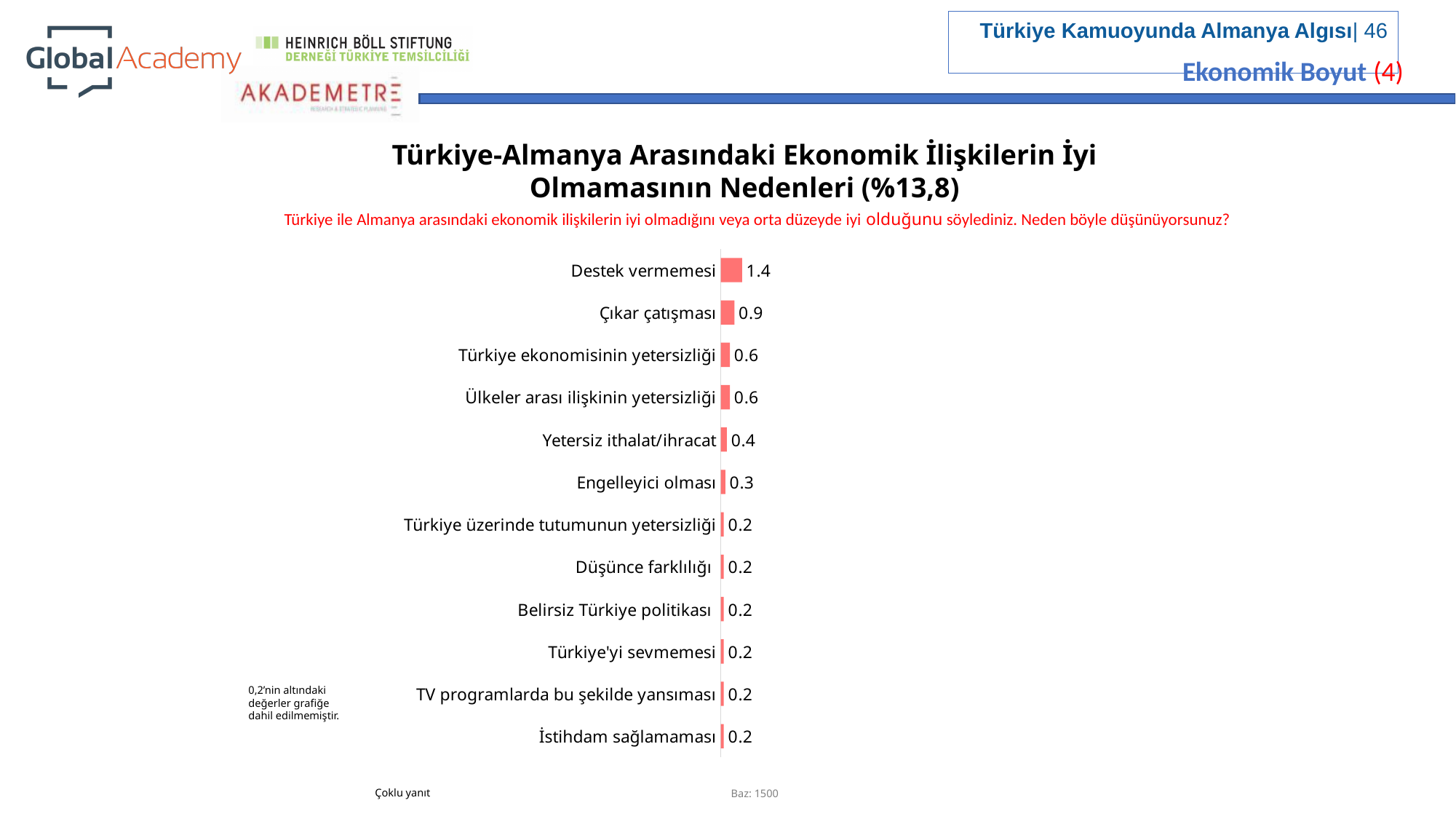
What is the value for "Engelleyici olması"? 0.3 Which category has the highest value? Destek vermemesi What is the difference between the values for "Destek vermemesi" and "Çıkar çatışması"? 0.5 How many categories are shown in the chart? 12 What is the difference between the values for "Türkiye ekonomisinin yetersizliği" and "Engelleyici olması"? 0.3 What is the value for "İstihdam sağlamaması"? 0.2 What is the value for "Destek vermemesi"? 1.4 What is the base (Baz) sample size noted below the chart? 1500 What is the value for "Yetersiz ithalat/ihracat"? 0.4 What is the value for "Çıkar çatışması"? 0.9 What kind of chart is shown on the slide? Bar chart Which is larger, the value for "Çıkar çatışması" or the value for "Yetersiz ithalat/ihracat"? Çıkar çatışması